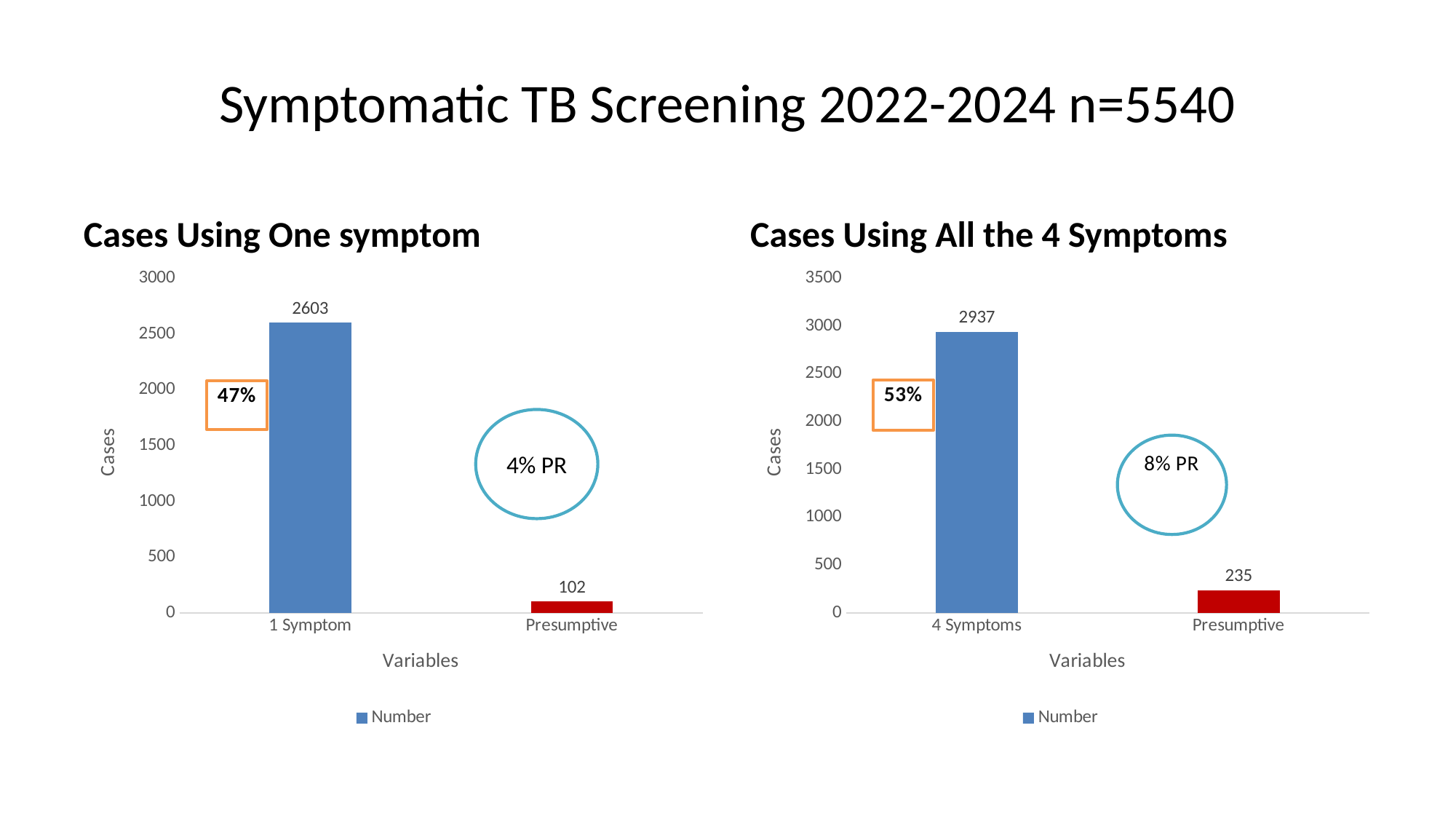
In the 'Cases Using All the 4 Symptoms' chart, what is the difference between the values for 4 Symptoms and Presumptive? 2702 In the 'Cases Using All the 4 Symptoms' chart, what is the value for Presumptive? 235 Which is larger: the Presumptive value in the 'Cases Using One symptom' chart or the Presumptive value in the 'Cases Using All the 4 Symptoms' chart? Cases Using All the 4 Symptoms In the 'Cases Using One symptom' chart, what is the value for Presumptive? 102 In the 'Cases Using All the 4 Symptoms' chart, which category has the lowest value? Presumptive In the 'Cases Using One symptom' chart, which category has the highest value? 1 Symptom What kind of chart is the 'Cases Using One symptom' chart? Bar chart In the 'Cases Using All the 4 Symptoms' chart, what is the value for 4 Symptoms? 2937 In the 'Cases Using One symptom' chart, what is the difference between the values for 1 Symptom and Presumptive? 2501 In the 'Cases Using One symptom' chart, what is the value for 1 Symptom? 2603 How many categories are shown on the x axis of the 'Cases Using All the 4 Symptoms' chart? 2 What series name does the legend of the 'Cases Using One symptom' chart list? Number